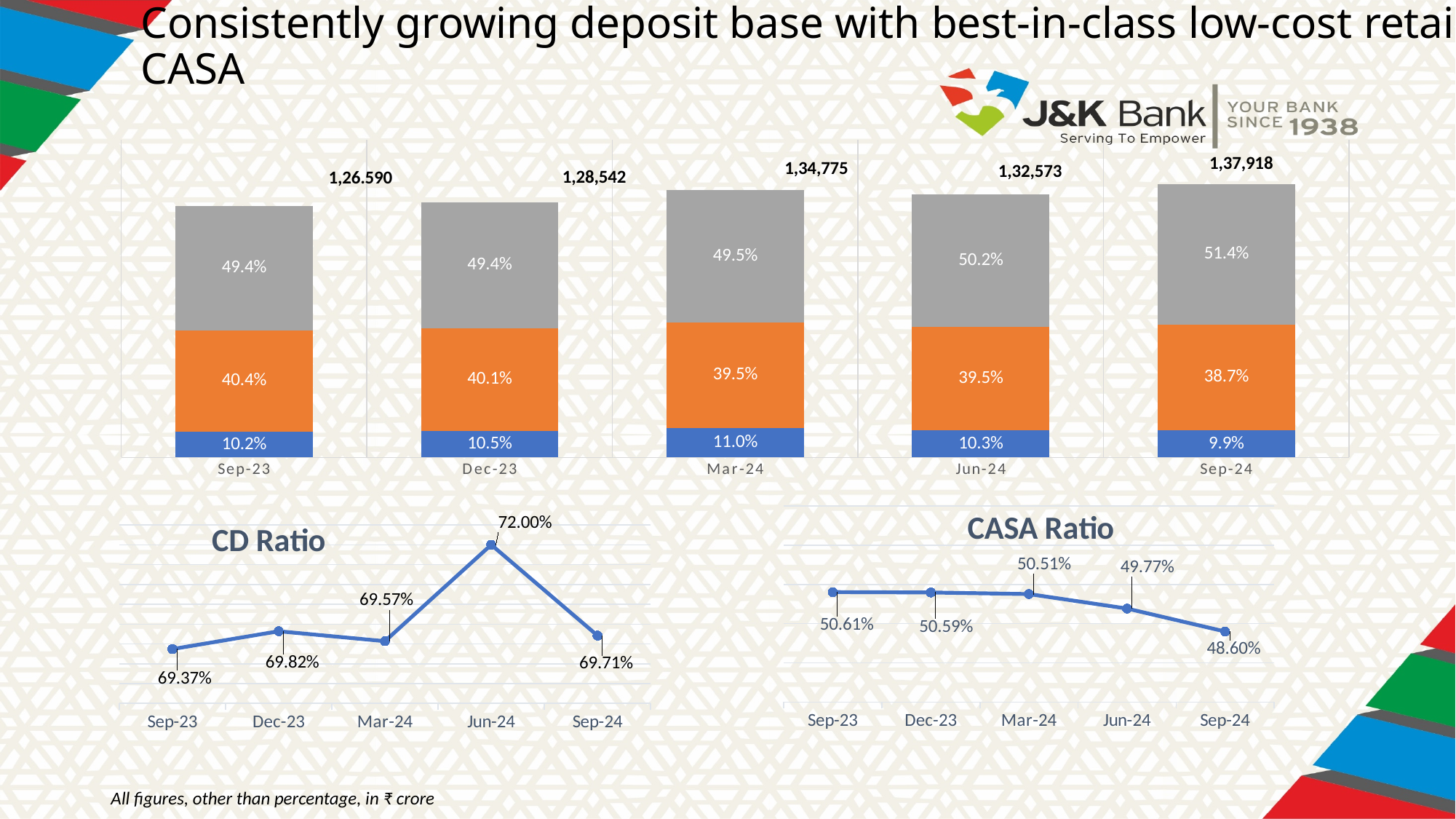
In the top stacked bar chart, how many periods are shown on the x axis? 5 In the CASA Ratio chart, what is the value for Sep-24? 48.60% In the top stacked bar chart, which period has the lowest total value printed above its bar? Sep-23 In the top stacked bar chart, what is the total deposit value shown above the Sep-24 bar? 1,37,918 In the CASA Ratio chart, do the values rise or fall from Mar-24 to Sep-24? fall In the CASA Ratio chart, what is the difference between the Sep-23 value and the Sep-24 value? 2.01% In the top stacked bar chart, which period has the highest total value printed above its bar? Sep-24 What kind of chart is the CD Ratio chart? line chart In the top stacked bar chart, what percentage is shown for the grey segment of the Jun-24 bar? 50.2% In the top stacked bar chart, what percentage is shown for the blue segment of the Mar-24 bar? 11.0% In the CD Ratio chart, which period has the lowest value? Sep-23 In the CD Ratio chart, what is the value for Jun-24? 72.00%